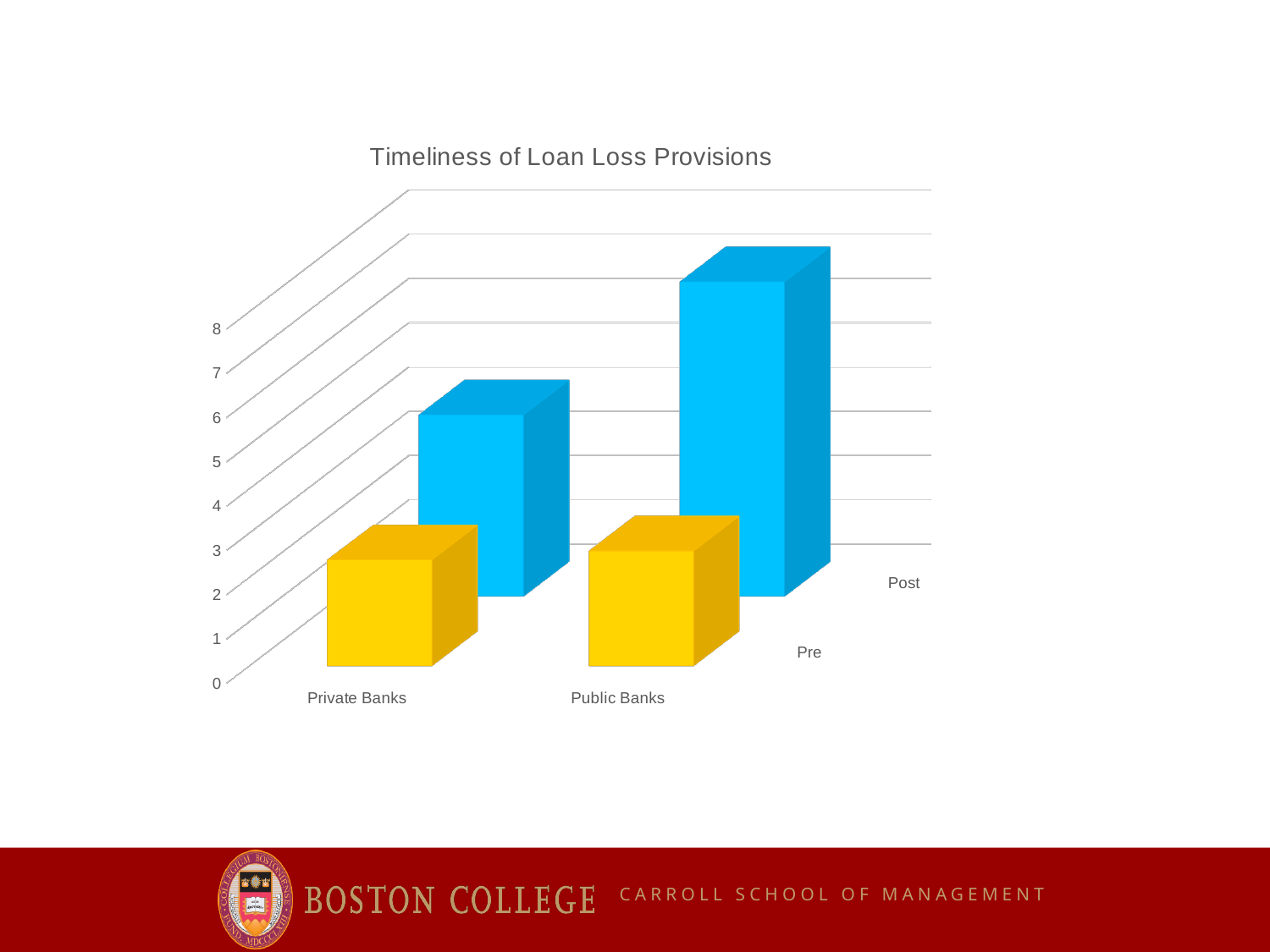
Is the Post value for Private Banks greater or less than 8? less Is the Post value for Public Banks greater or less than 4? greater How many categories are shown on the x axis of the chart? 2 What kind of chart is shown on the slide? bar chart For Public Banks, which is larger, the Pre value or the Post value? Post Which category has the highest Post value? Public Banks How many series does the chart show? 2 Is the Pre value for Private Banks greater or less than 5? less What are the two series shown in the chart? Pre and Post For Private Banks, which is larger, the Pre value or the Post value? Post Which category has the lowest Post value? Private Banks What is the title of the chart? Timeliness of Loan Loss Provisions